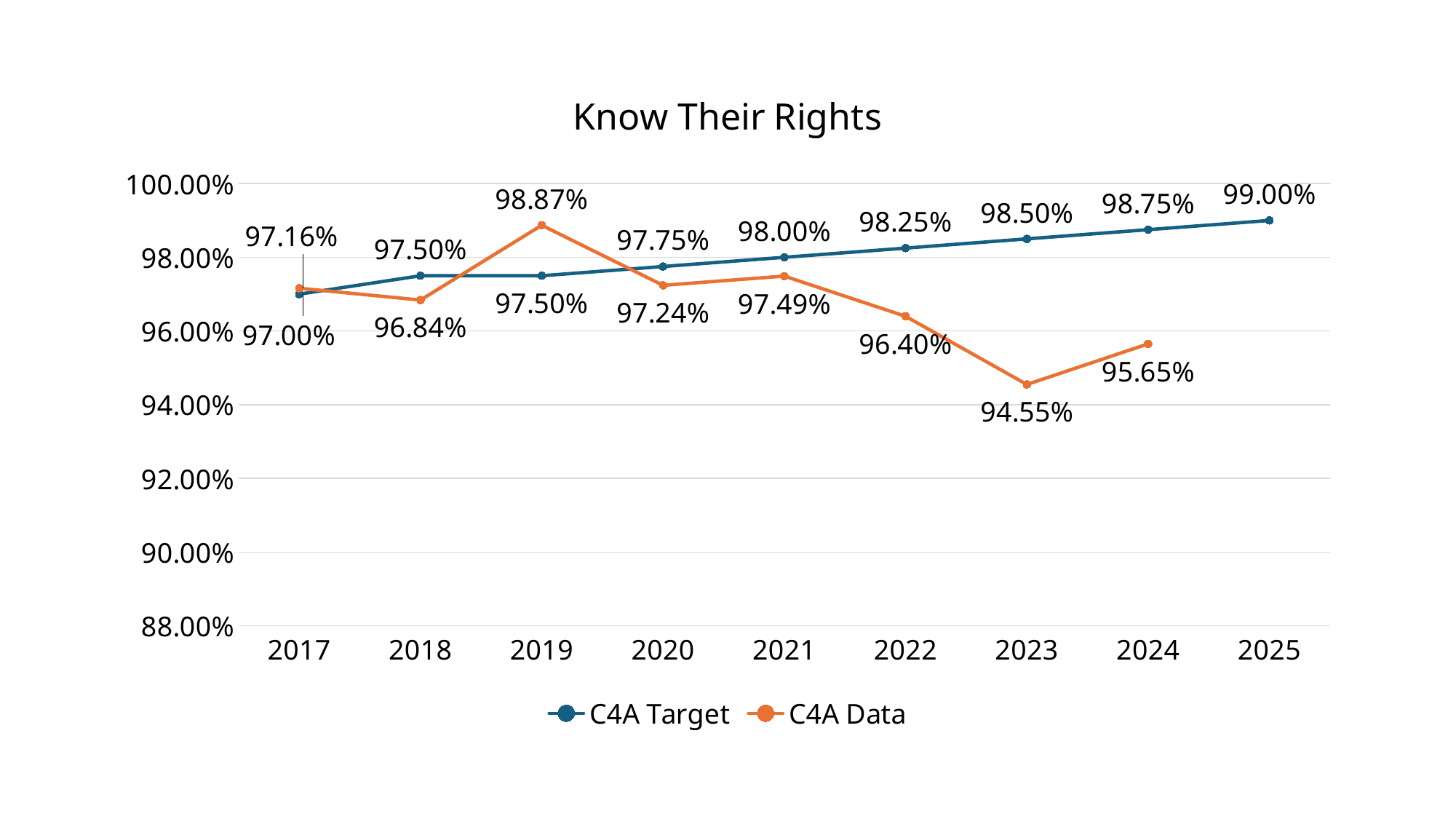
What is the difference between the C4A Target and C4A Data values in 2023? 3.95% What is the C4A Data value for 2024? 95.65% In which year is the C4A Data value lowest? 2023 How many data points does the C4A Data series have? 8 How many series does the legend list? 2 In 2019, which series has the larger value, C4A Target or C4A Data? C4A Data Does the C4A Target series rise or fall from 2017 to 2025? Rises In which year is the C4A Data value highest? 2019 What is the title of the chart? Know Their Rights What is the C4A Target value for 2025? 99.00% What is the C4A Data value for 2019? 98.87% What kind of chart is shown on the slide? Line chart